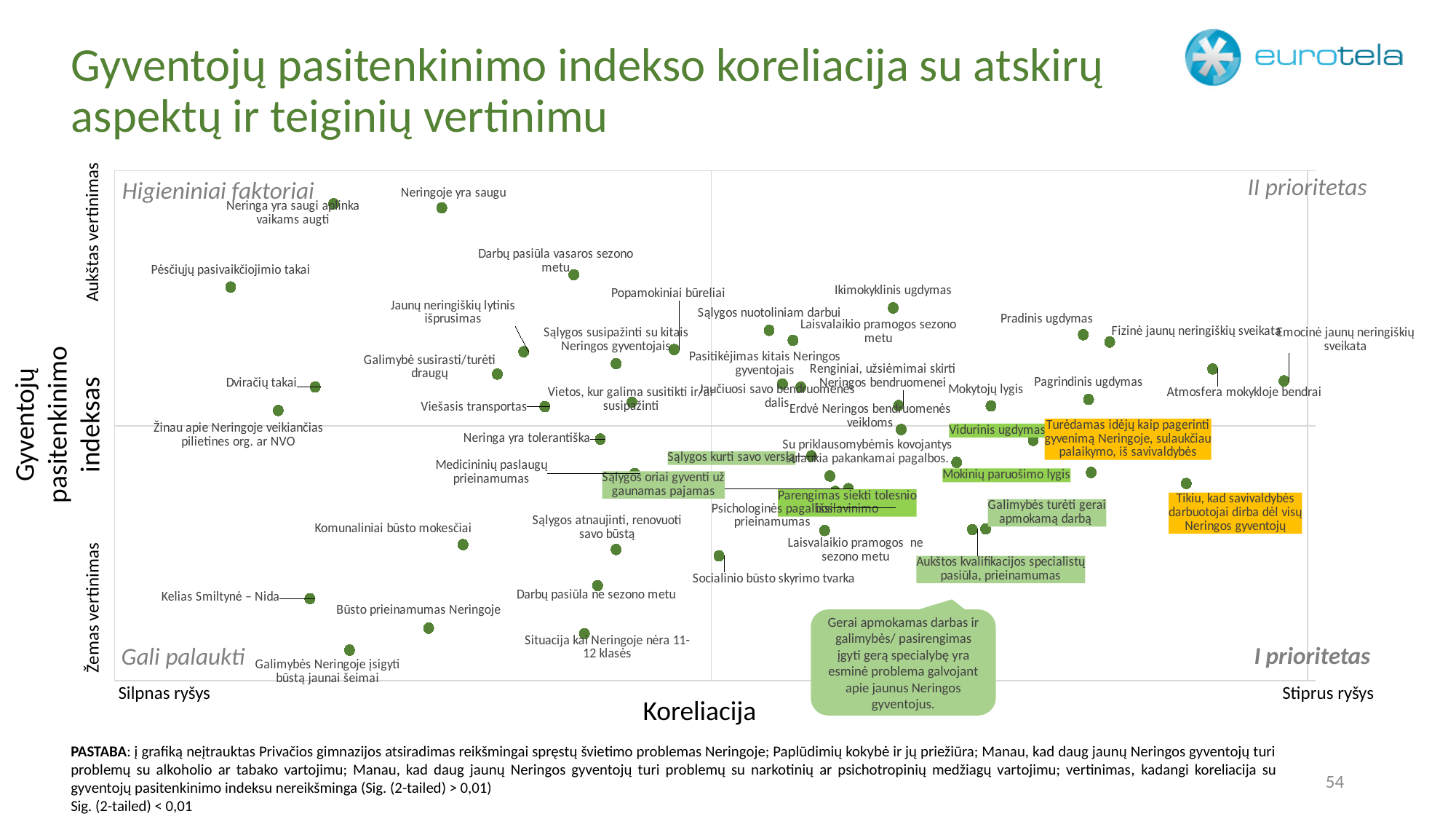
Which point is plotted furthest to the left (weakest correlation) on the chart? Pėsčiųjų pasivaikščiojimio takai What is the label of the vertical axis of the chart? Gyventojų pasitenkinimo indeksas What is the label of the horizontal axis of the chart? Koreliacija Which point is plotted further to the right: "Pradinis ugdymas" or "Viešasis transportas"? Pradinis ugdymas In which quadrant of the chart does the point "Kelias Smiltynė – Nida" fall? Gali palaukti Which point is plotted lower on the vertical axis: "Komunaliniai būsto mokesčiai" or "Darbų pasiūla vasaros sezono metu"? Komunaliniai būsto mokesčiai In which quadrant of the chart does the point "Pradinis ugdymas" fall? II prioritetas Which point is plotted higher on the vertical axis: "Neringoje yra saugu" or "Dviračių takai"? Neringoje yra saugu What kind of chart is shown on the slide? Scatter chart Which point is plotted lowest on the vertical axis of the chart? Galimybės Neringoje įsigyti būstą jaunai šeimai Which point is plotted furthest to the right (strongest correlation) on the chart? Emocinė jaunų neringiškių sveikata In which quadrant of the chart does the point "Tikiu, kad savivaldybės darbuotojai dirba dėl visų Neringos gyventojų" fall? I prioritetas